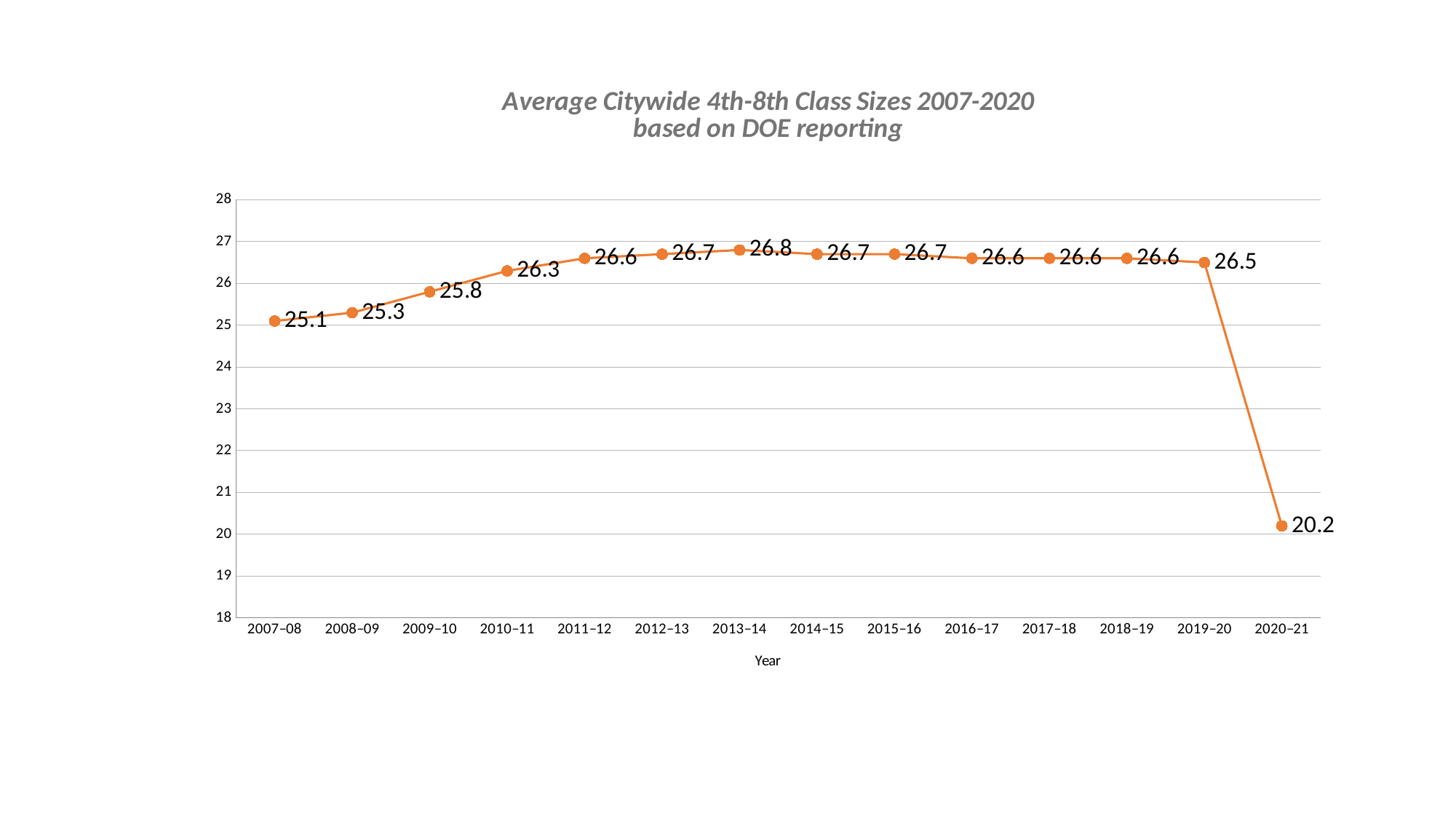
What is the title of the chart? Average Citywide 4th-8th Class Sizes 2007-2020 based on DOE reporting Which year has the highest average class size? 2013–14 What is the difference between the average class size in 2007–08 and 2013–14? 1.7 What kind of chart is shown on the slide? Line chart Which year has the lowest average class size? 2020–21 How many years are plotted on the chart? 14 What is the average class size for 2010–11? 26.3 What is the difference between the average class size in 2019–20 and 2020–21? 6.3 Which is larger, the average class size in 2009–10 or in 2011–12? 2011–12 What is the average class size for 2013–14? 26.8 What is the average class size for 2020–21? 20.2 What is the average class size for 2007–08? 25.1